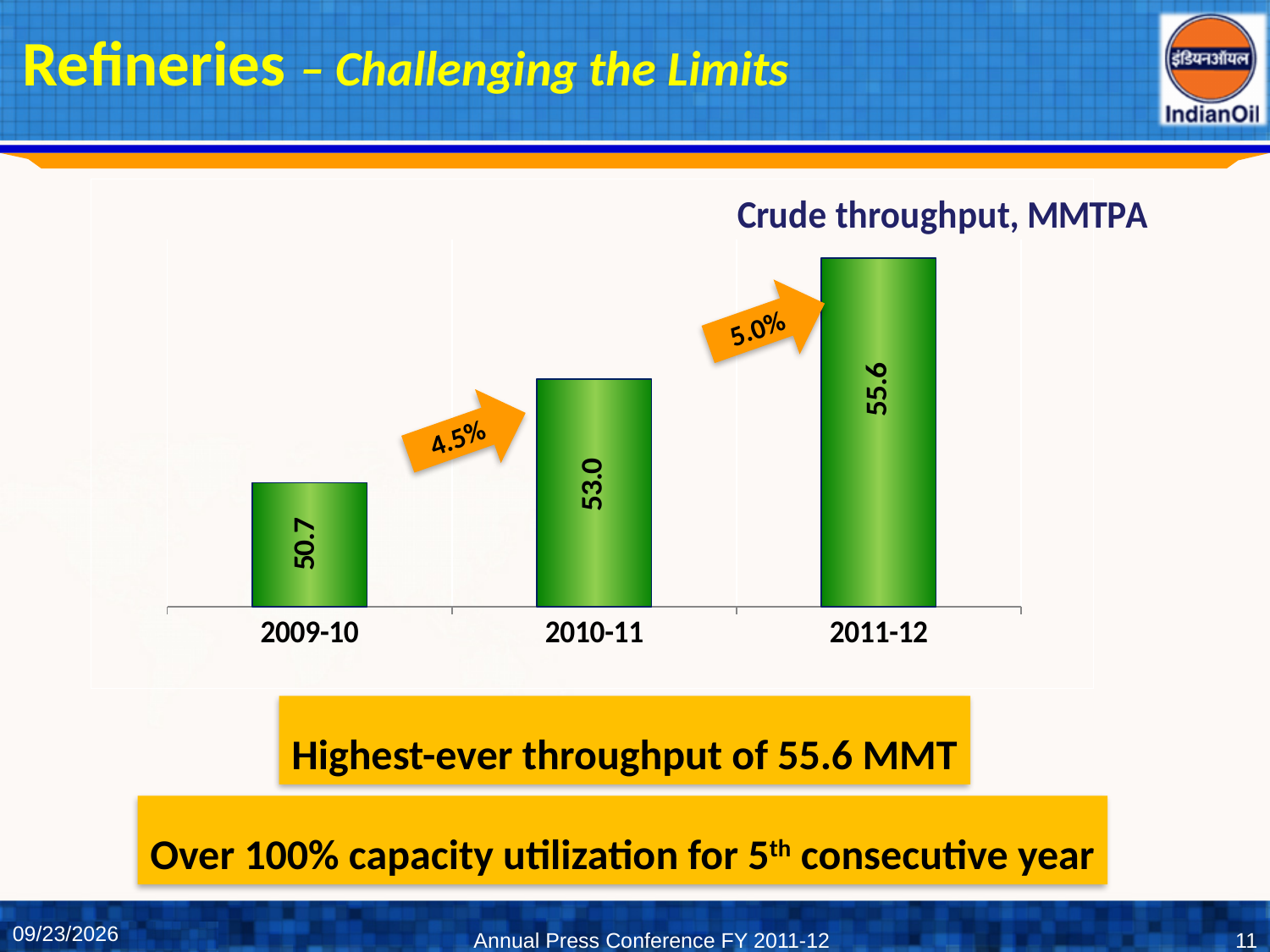
Which year has the highest crude throughput? 2011-12 What is the crude throughput for 2009-10? 50.7 Do the crude throughput values rise or fall from 2009-10 to 2011-12? Rise What is the difference in crude throughput between 2010-11 and 2009-10? 2.3 Which year has the lowest crude throughput? 2009-10 What is the crude throughput for 2011-12? 55.6 What is the difference in crude throughput between 2011-12 and 2009-10? 4.9 What kind of chart is shown on the slide? Bar chart Which year has a larger crude throughput, 2010-11 or 2011-12? 2011-12 How many years are shown on the chart? 3 What percentage growth is shown by the arrow between 2010-11 and 2011-12? 5.0% What is the crude throughput for 2010-11? 53.0